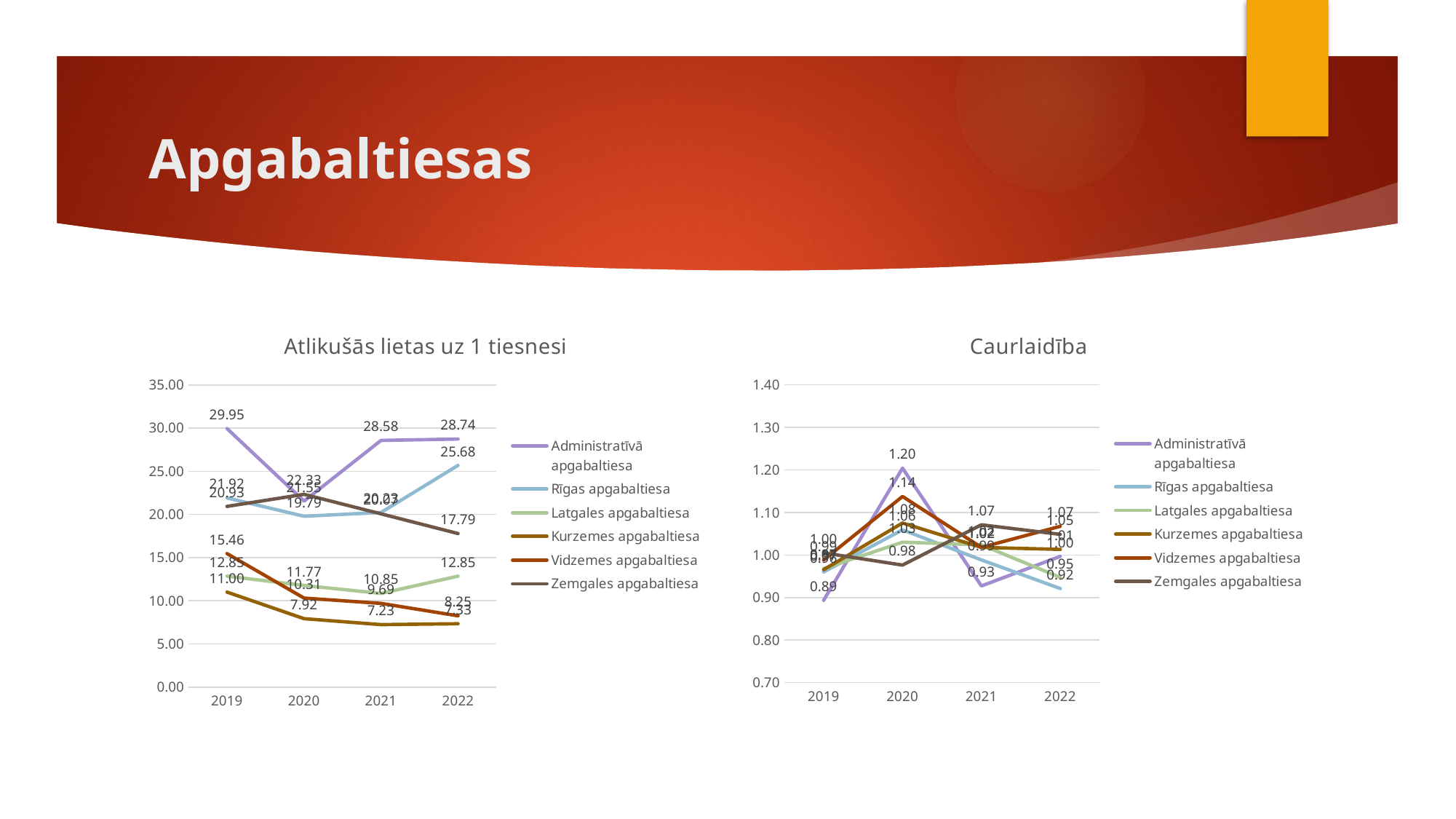
In the 'Caurlaidība' chart, which series has the lowest value in 2019? Administratīvā apgabaltiesa In the 'Caurlaidība' chart, what is the value for Administratīvā apgabaltiesa in 2020? 1.20 In the 'Caurlaidība' chart, what is the value for Rīgas apgabaltiesa in 2022? 0.92 In the 'Atlikušās lietas uz 1 tiesnesi' chart, what is the value for Kurzemes apgabaltiesa in 2021? 7.23 In the 'Atlikušās lietas uz 1 tiesnesi' chart, what is the value for Administratīvā apgabaltiesa in 2019? 29.95 In the 'Atlikušās lietas uz 1 tiesnesi' chart, what is the difference between the Administratīvā apgabaltiesa values for 2019 and 2020? 8.40 What kind of chart is the 'Atlikušās lietas uz 1 tiesnesi' chart? line chart In the 'Atlikušās lietas uz 1 tiesnesi' chart, which series has the highest value in 2019? Administratīvā apgabaltiesa In the 'Caurlaidība' chart, which is larger in 2020: Vidzemes apgabaltiesa or Zemgales apgabaltiesa? Vidzemes apgabaltiesa In the 'Atlikušās lietas uz 1 tiesnesi' chart, does the Vidzemes apgabaltiesa line rise or fall from 2019 to 2022? fall How many series does the legend of the 'Atlikušās lietas uz 1 tiesnesi' chart list? 6 How many years are shown on the x axis of the 'Caurlaidība' chart? 4